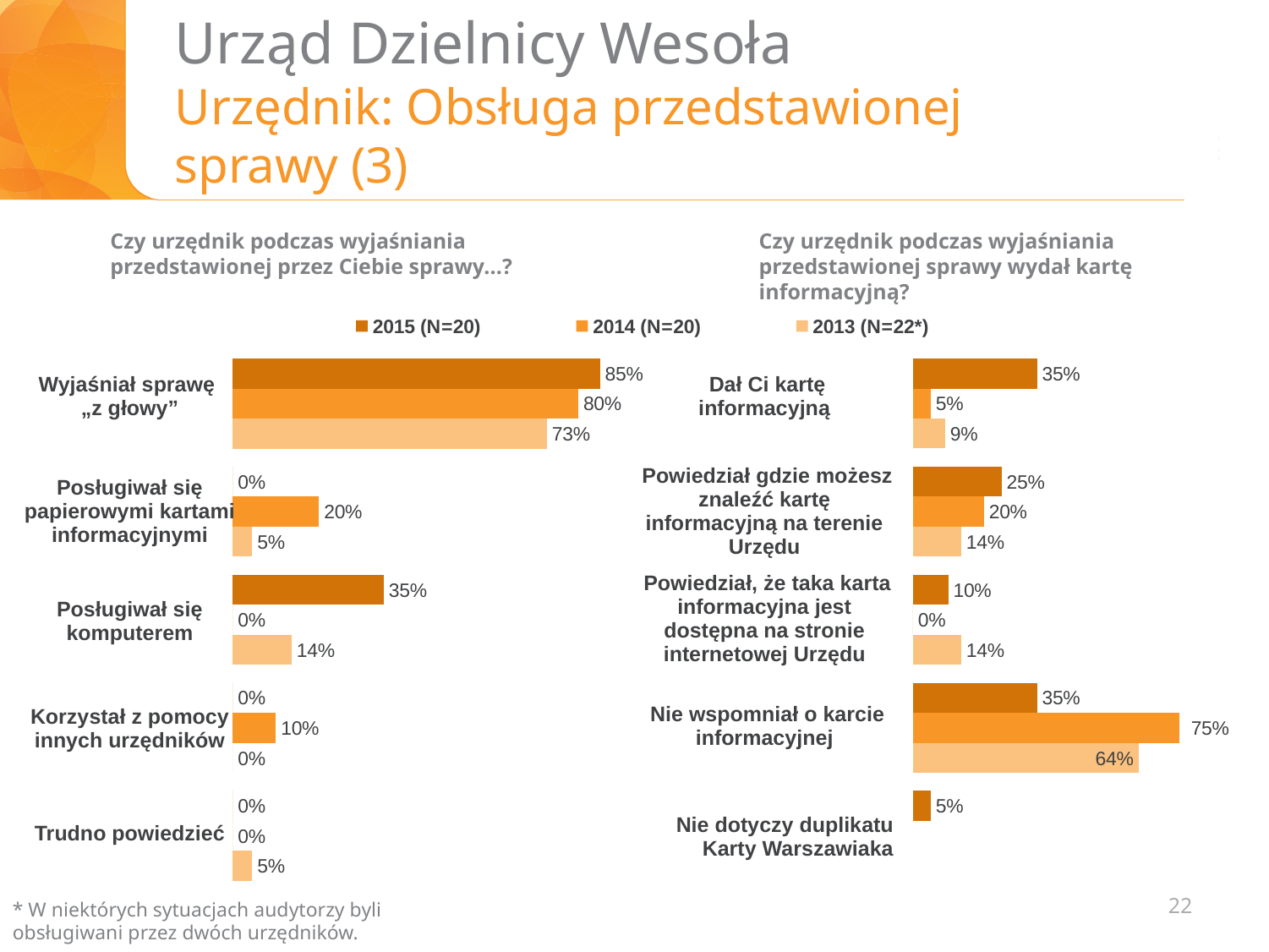
In the left chart, which category has the highest 2015 value? Wyjaśniał sprawę „z głowy” In the right chart, what is the 2015 value for "Dał Ci kartę informacyjną"? 35% How many categories are shown in the left chart? 5 In the right chart, which is larger for "Powiedział gdzie możesz znaleźć kartę informacyjną na terenie Urzędu": the 2015 value or the 2013 value? 2015 In the left chart ("Czy urzędnik podczas wyjaśniania przedstawionej przez Ciebie sprawy...?"), what is the 2015 value for "Wyjaśniał sprawę „z głowy”"? 85% In the left chart, what is the 2013 value for "Posługiwał się komputerem"? 14% What kind of chart is the right chart? Bar chart How many series does the legend list? 3 In the right chart, what is the difference between the 2014 and 2015 values for "Nie wspomniał o karcie informacyjnej"? 40 percentage points In the right chart ("Czy urzędnik podczas wyjaśniania przedstawionej sprawy wydał kartę informacyjną?"), what is the 2014 value for "Nie wspomniał o karcie informacyjnej"? 75% In the right chart, which category has the highest 2013 value? Nie wspomniał o karcie informacyjnej In the left chart, what is the difference between the 2015 and 2013 values for "Wyjaśniał sprawę „z głowy”"? 12 percentage points